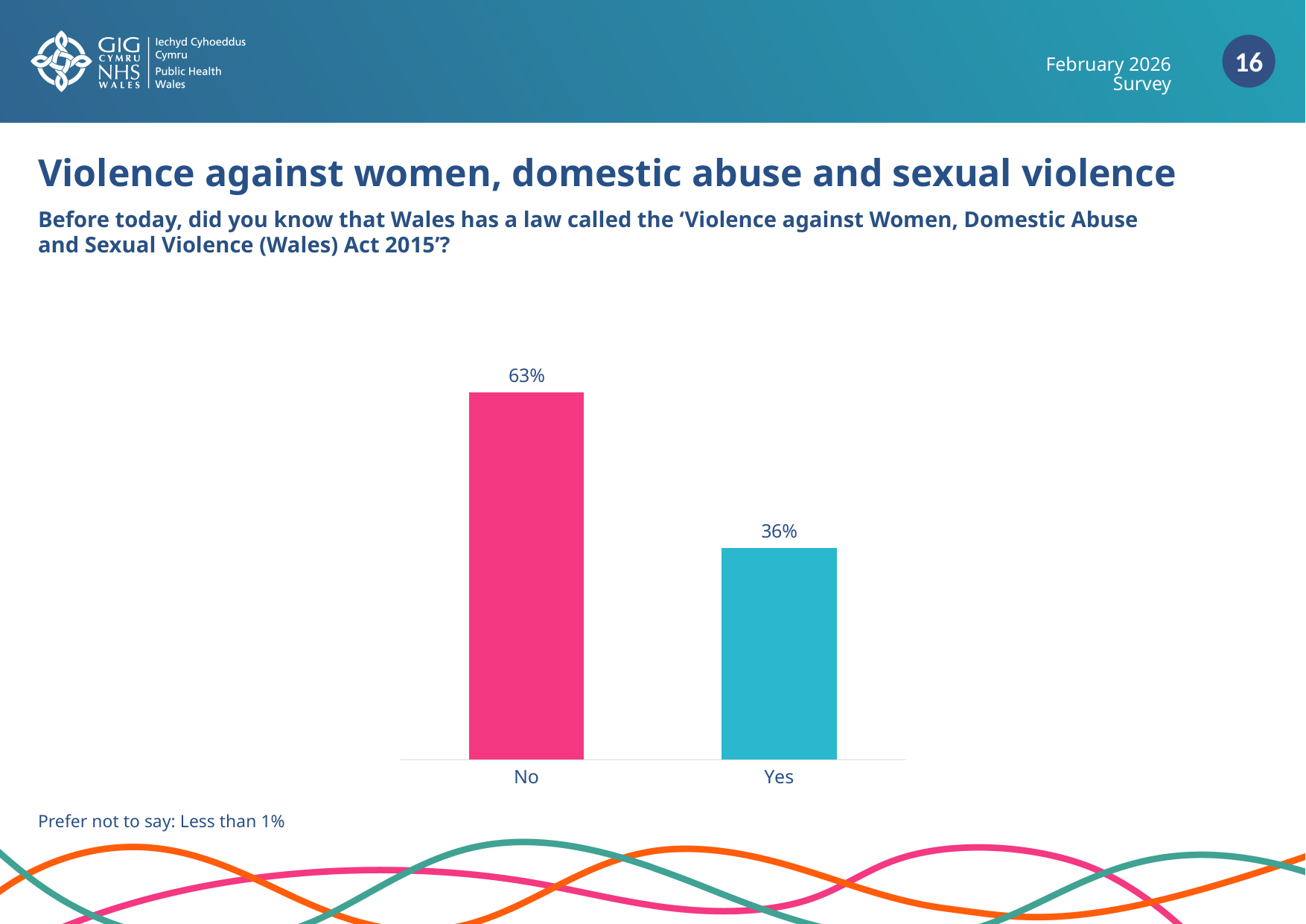
What is the difference in percentage points between the 'No' and 'Yes' responses? 27 What kind of chart is shown on the slide? Bar chart According to the note below the chart, what percentage answered 'Prefer not to say'? Less than 1% Which is larger, the percentage for 'No' or for 'Yes'? No What percentage of respondents answered 'No'? 63% Which response has the lowest percentage? Yes Which response has the highest percentage? No What percentage of respondents answered 'Yes'? 36% What colour is the bar for 'No'? Pink How many response categories are shown in the chart? 2